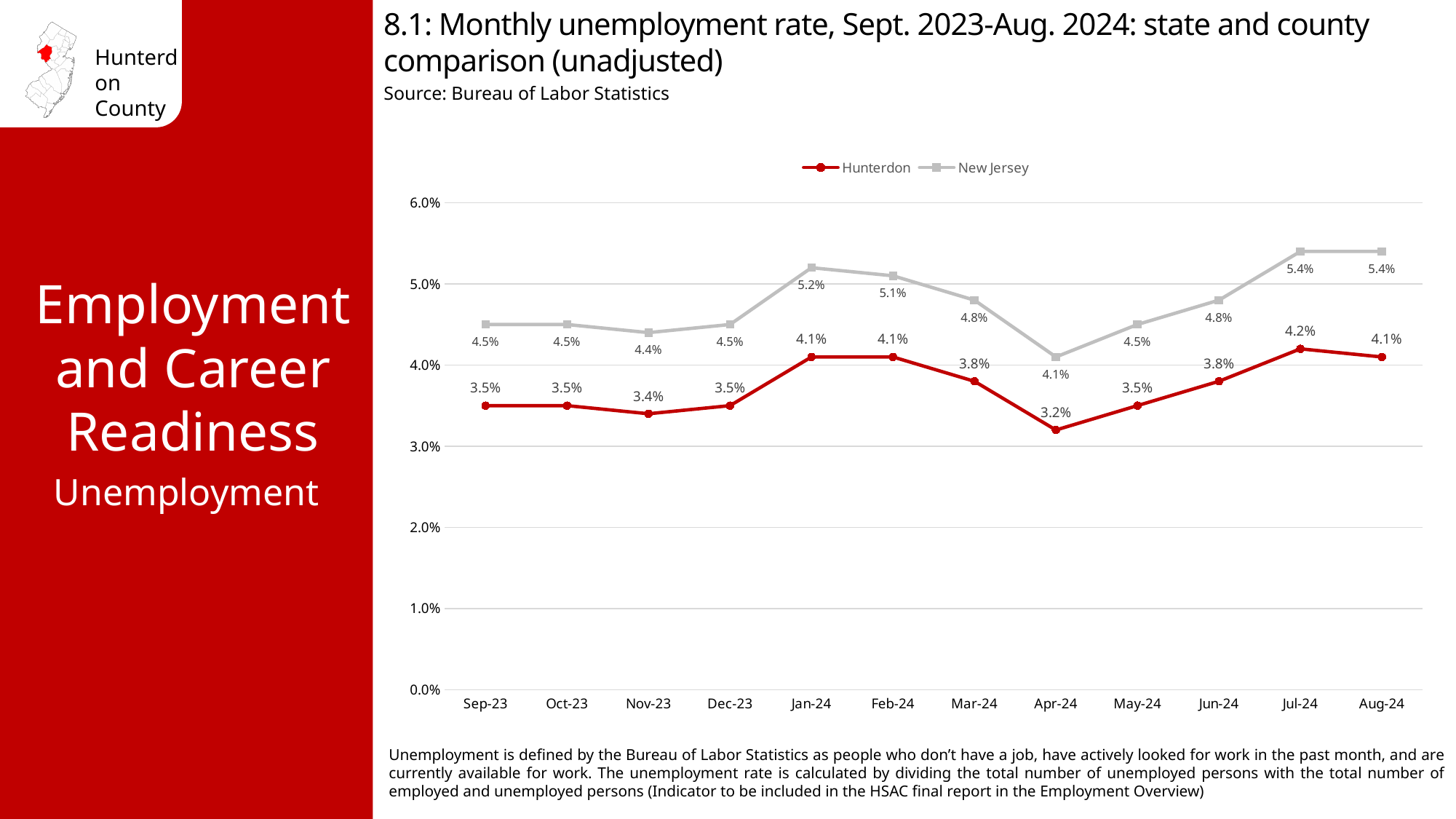
How many series does the legend list? 2 Which had the higher unemployment rate in Mar-24, Hunterdon or New Jersey? New Jersey Is the New Jersey unemployment rate in Jul-24 greater or less than 5.0%? greater How many months are shown on the x axis? 12 What is the difference between the New Jersey and Hunterdon unemployment rates in Aug-24? 1.3% Did the Hunterdon unemployment rate rise or fall from Apr-24 to Jul-24? Rise What was the Hunterdon unemployment rate in Jul-24? 4.2% What was the New Jersey unemployment rate in Jan-24? 5.2% In which month was the Hunterdon unemployment rate lowest? Apr-24 What was the Hunterdon unemployment rate in Apr-24? 3.2% In which month was the New Jersey unemployment rate lowest? Apr-24 What kind of chart is shown on the slide? Line chart